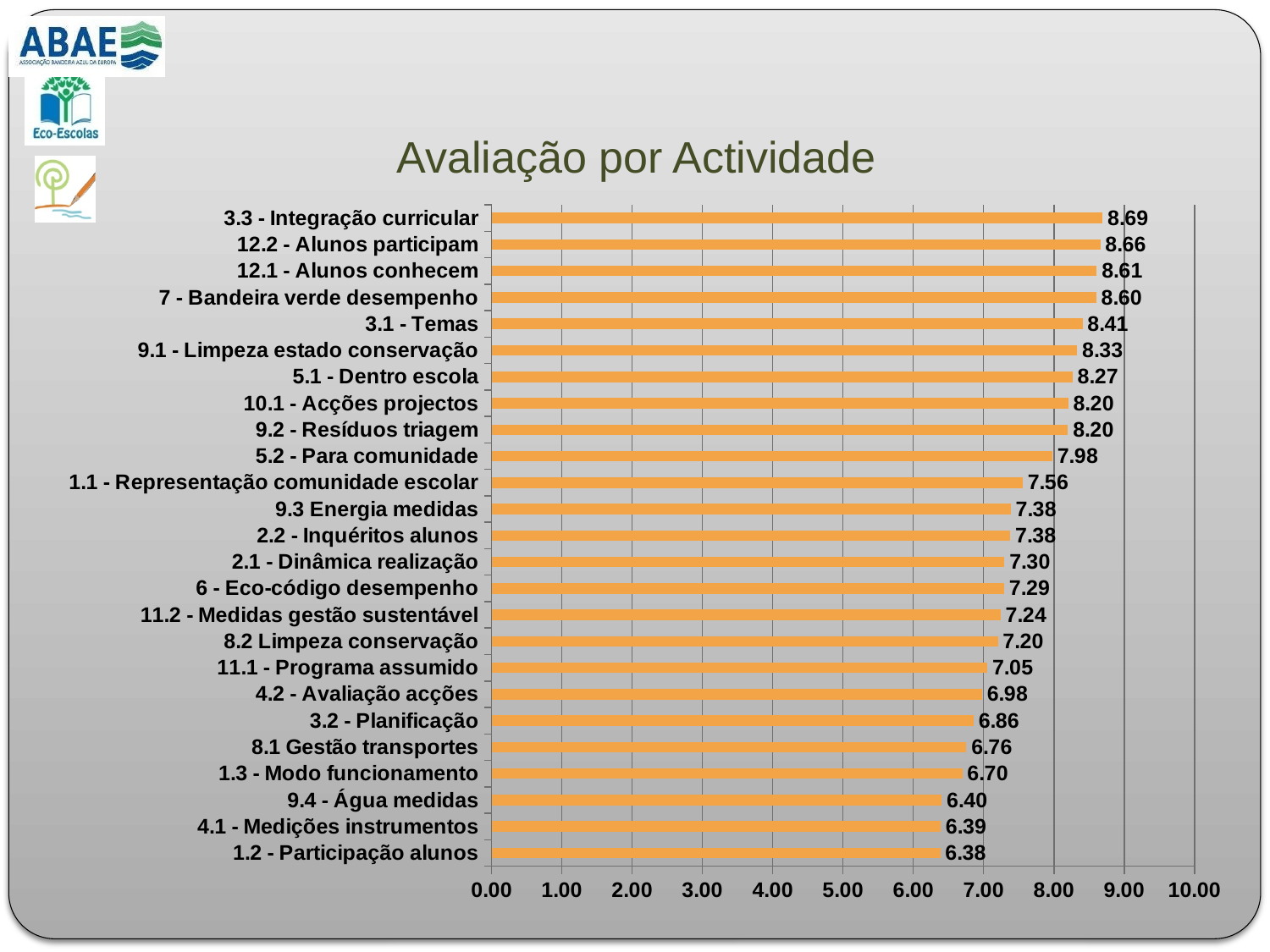
Which activity has the lowest value? 1.2 - Participação alunos What is the value for 3.3 - Integração curricular? 8.69 Which is larger, the value for 7 - Bandeira verde desempenho or the value for 2.1 - Dinâmica realização? 7 - Bandeira verde desempenho What is the difference between the values for 3.1 - Temas and 5.2 - Para comunidade? 0.43 Which activity has the highest value? 3.3 - Integração curricular What kind of chart is shown on the slide? bar chart What is the value for 11.1 - Programa assumido? 7.05 What is the value for 1.2 - Participação alunos? 6.38 Is the value for 9.4 - Água medidas greater or less than 7.00? less What is the difference between the values for 3.3 - Integração curricular and 1.2 - Participação alunos? 2.31 How many activities are shown in the chart? 25 What is the value for 9.1 - Limpeza estado conservação? 8.33